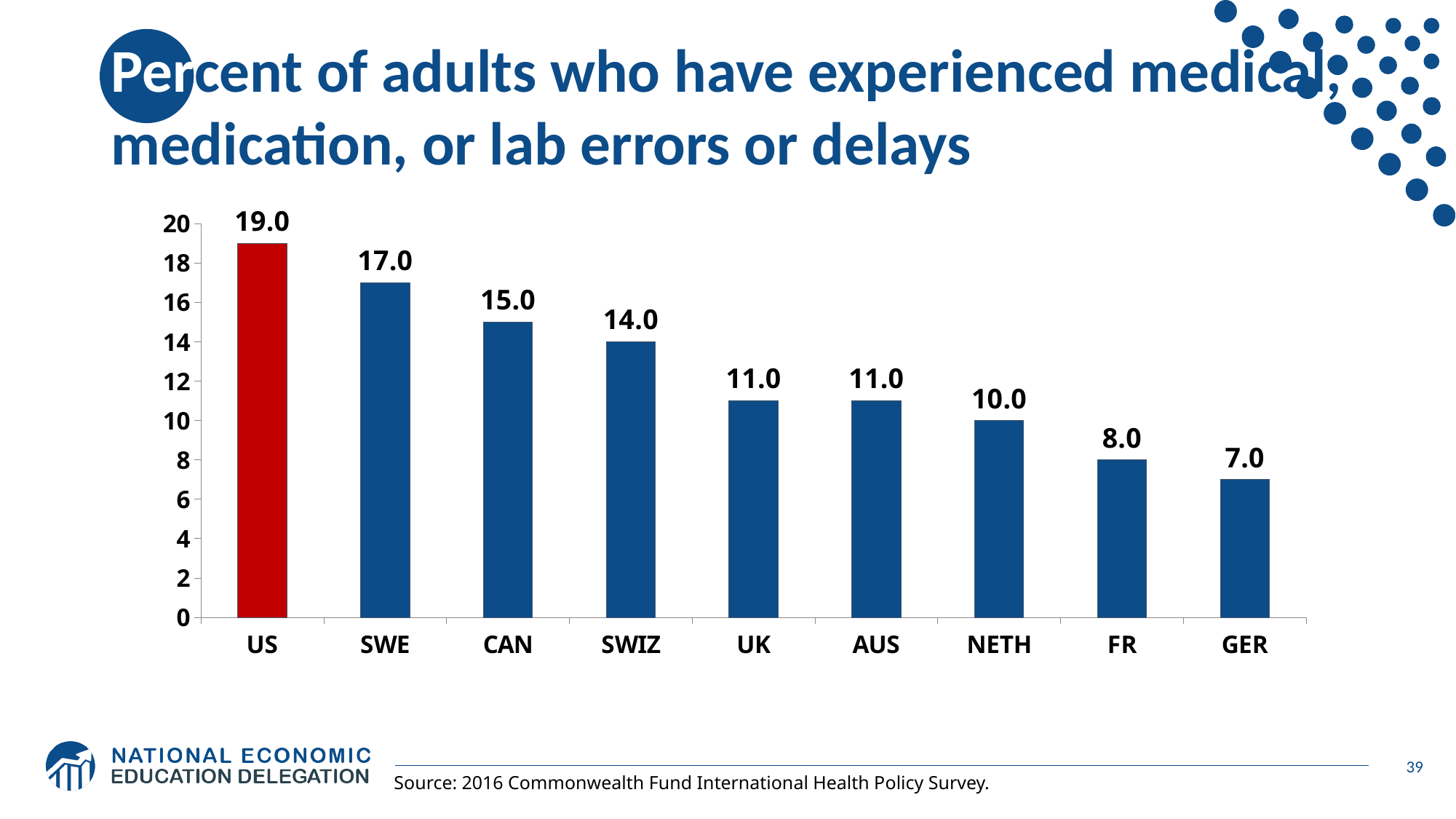
What is the difference between the values for SWE and CAN? 2.0 Is the value for CAN greater or less than 10? greater What is the value for NETH? 10.0 Which country has the highest value? US What is the value for SWIZ? 14.0 What is the difference between the values for the US and GER? 12.0 Which is larger, the value for FR or the value for NETH? NETH Which country has the lowest value? GER How many countries are shown in the chart? 9 Which bar is coloured red rather than blue? US What kind of chart is shown on the slide? bar chart What is the value for the US? 19.0